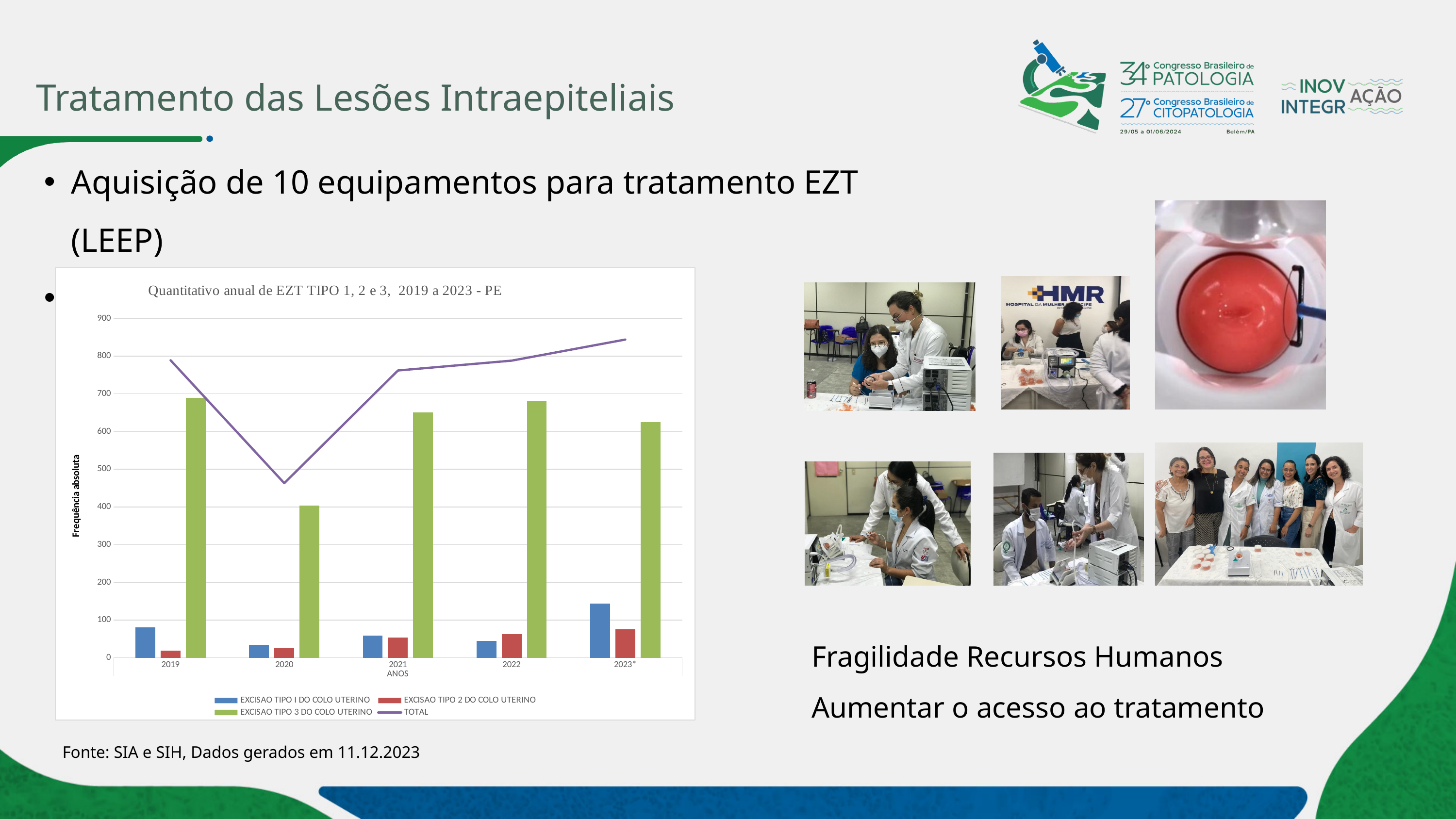
Is the EXCISAO TIPO 3 DO COLO UTERINO value for 2020 greater or less than 500? less In which year is the TOTAL line at its lowest point? 2020 In which year is the TOTAL line at its highest point? 2023* In which year is the EXCISAO TIPO 3 DO COLO UTERINO bar lowest? 2020 What is the title of the chart? Quantitativo anual de EZT TIPO 1, 2 e 3, 2019 a 2023 - PE How many years are shown on the x axis of the chart? 5 Which series in the chart is drawn as a line rather than bars? TOTAL Which year has the larger EXCISAO TIPO I DO COLO UTERINO value, 2019 or 2023*? 2023* Does the TOTAL line rise or fall from 2020 to 2023*? rise How many series does the chart legend list? 4 Is the TOTAL value for 2023* greater or less than 800? greater Is the EXCISAO TIPO 3 DO COLO UTERINO value for 2019 greater or less than 600? greater